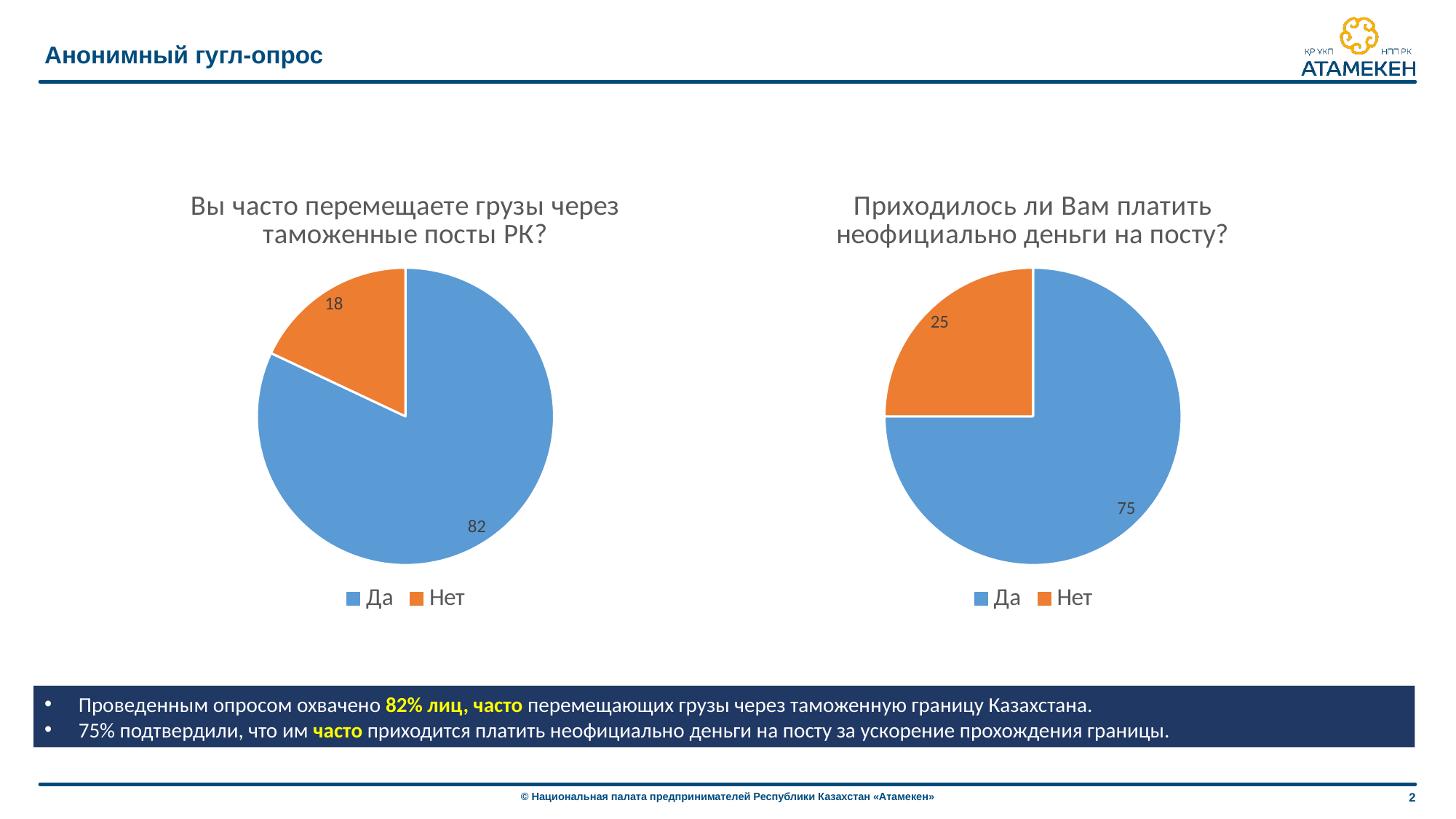
What type of chart is used on the left side of the slide? pie chart In the right chart titled "Приходилось ли Вам платить неофициально деньги на посту?", what is the value for "Нет"? 25 In the left chart, what is the difference between the values for "Да" and "Нет"? 64 In the left chart, which category has the largest slice? Да How many categories does the right chart show? 2 What colour is the "Нет" slice in the right chart? orange In the left chart titled "Вы часто перемещаете грузы через таможенные посты РК?", what is the value for "Да"? 82 In the right chart, which category has the smallest slice? Нет Is the value for "Нет" larger in the left chart or in the right chart? right chart In the right chart titled "Приходилось ли Вам платить неофициально деньги на посту?", what is the value for "Да"? 75 In the left chart titled "Вы часто перемещаете грузы через таможенные посты РК?", what is the value for "Нет"? 18 In the right chart, what is the difference between the values for "Да" and "Нет"? 50